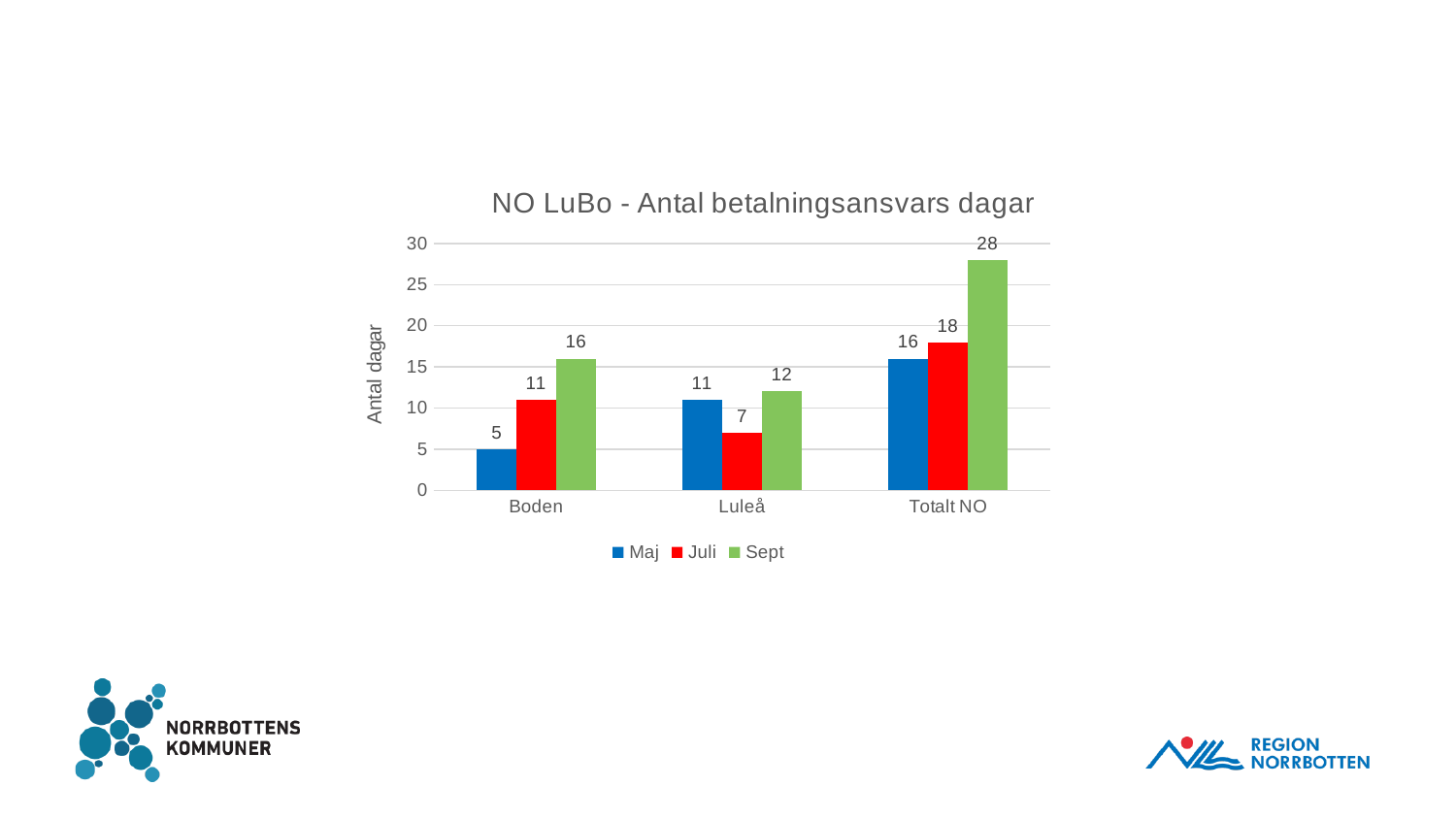
What kind of chart is shown? Bar chart What is the value for Juli in Luleå? 7 What is the label of the y axis? Antal dagar How many categories are shown on the x axis? 3 What is the difference between the Sept and Maj values for Boden? 11 What is the value for Sept in Totalt NO? 28 What is the title of the chart? NO LuBo - Antal betalningsansvars dagar Which category has the lowest Maj value? Boden Which is larger for Luleå, the Maj value or the Juli value? Maj How many series does the legend list? 3 What is the value for Maj in Boden? 5 Which category has the highest Sept value? Totalt NO